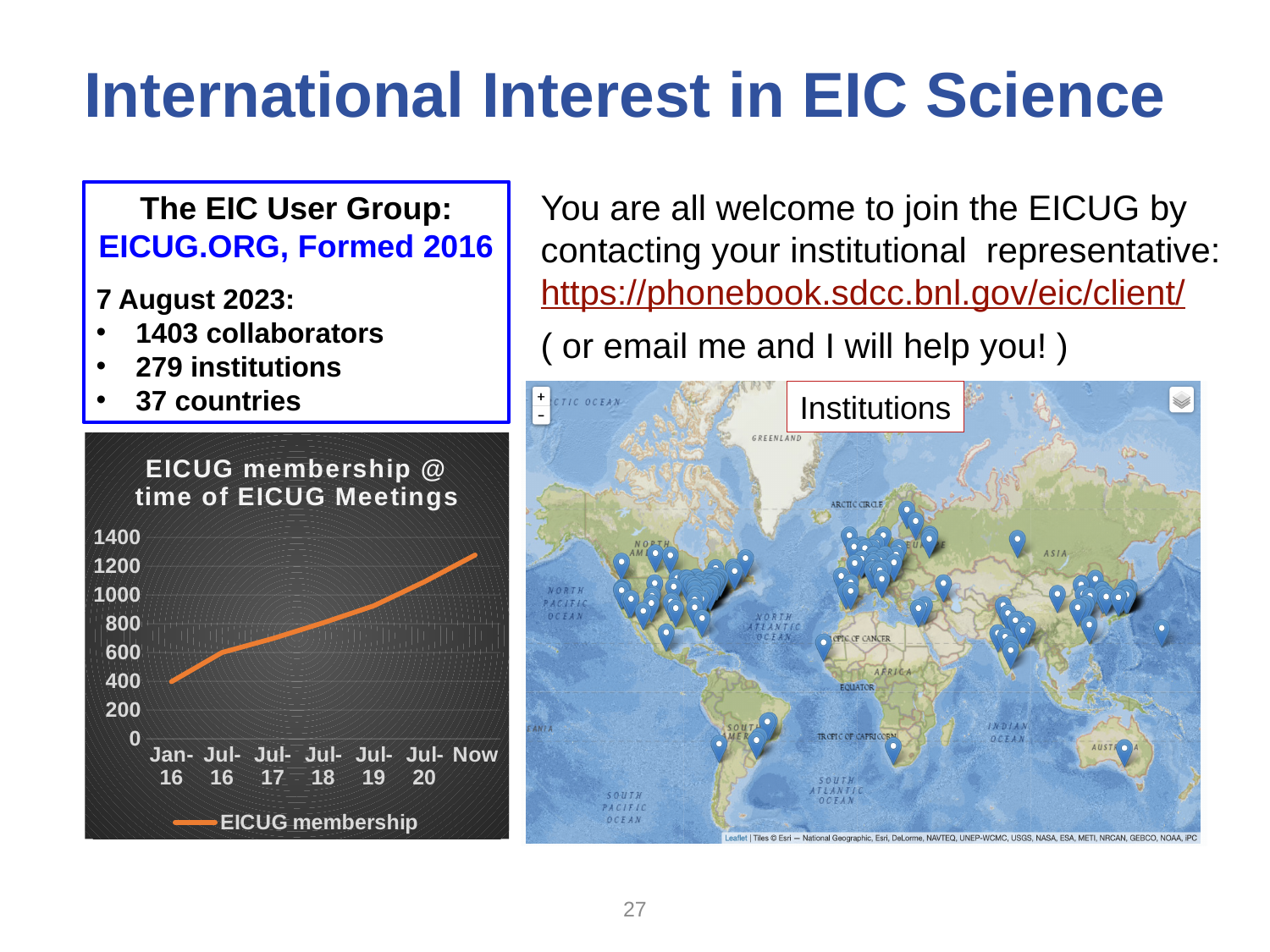
On the EICUG membership chart, is the value for Jul-19 greater or less than 800? greater Which point on the EICUG membership chart has the highest value? Now On the EICUG membership chart, is the value for Now greater or less than 1200? greater What is the legend entry on the EICUG membership chart? EICUG membership On the EICUG membership chart, which is larger, the value for Jul-17 or the value for Jul-20? Jul-20 On the EICUG membership chart, is the value for Jul-20 greater or less than 1000? greater Which point on the EICUG membership chart has the lowest value? Jan-16 What kind of chart is the 'EICUG membership @ time of EICUG Meetings' chart? line chart How many data points are plotted on the EICUG membership chart? 7 Do the values on the EICUG membership chart rise or fall from Jan-16 to Now? rise How many series does the legend of the EICUG membership chart list? 1